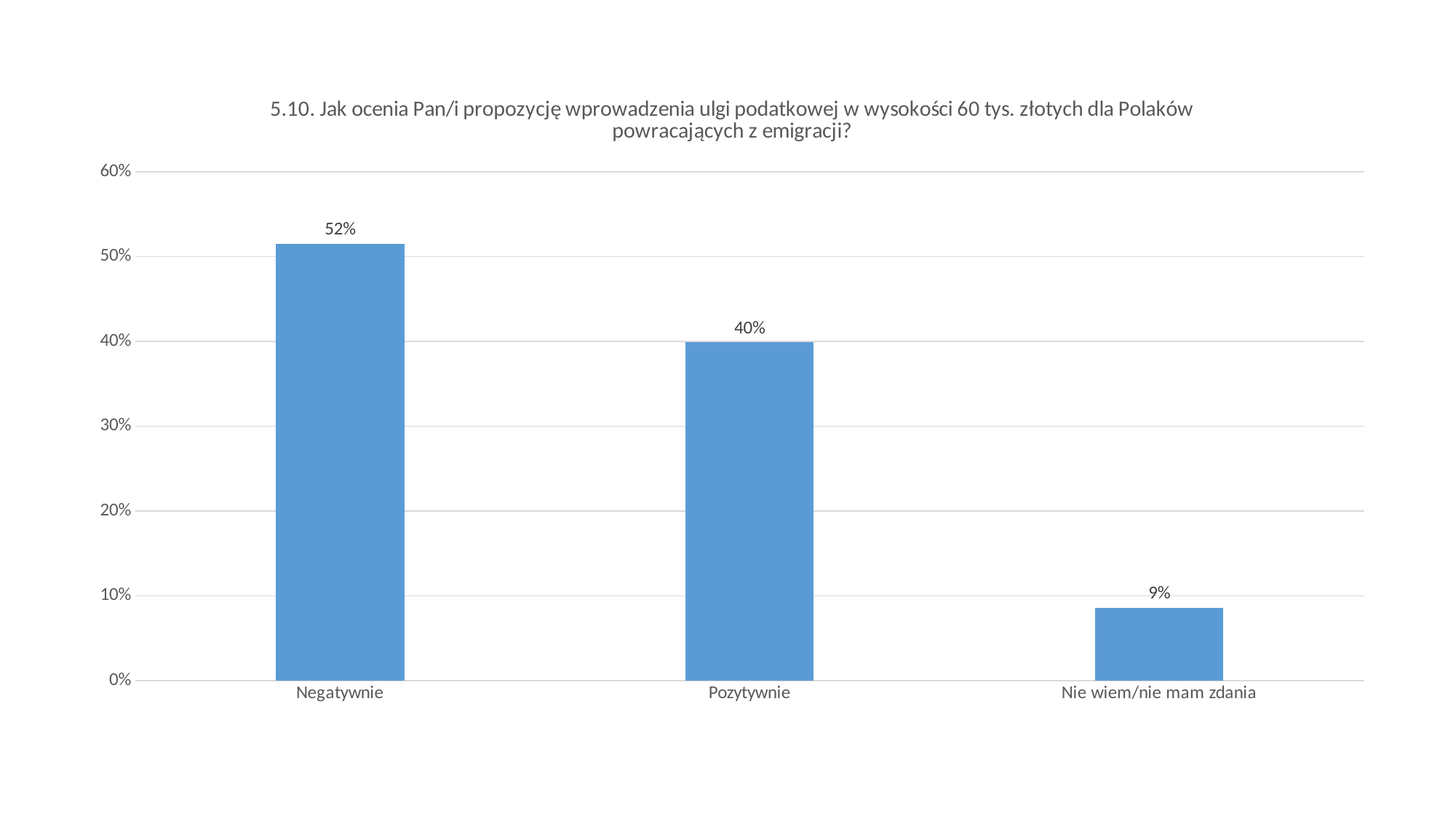
What kind of chart is shown on the slide? bar chart What is the value for Negatywnie? 52% What is the value for Pozytywnie? 40% Is the value for Negatywnie greater or less than 50%? greater What is the difference between the values for Negatywnie and Pozytywnie? 12% What is the value for Nie wiem/nie mam zdania? 9% What is the highest value shown on the vertical axis? 60% Which is larger, the value for Pozytywnie or the value for Nie wiem/nie mam zdania? Pozytywnie Which category has the highest value? Negatywnie Which category has the lowest value? Nie wiem/nie mam zdania What is the difference between the values for Pozytywnie and Nie wiem/nie mam zdania? 31% How many categories are shown on the x axis? 3